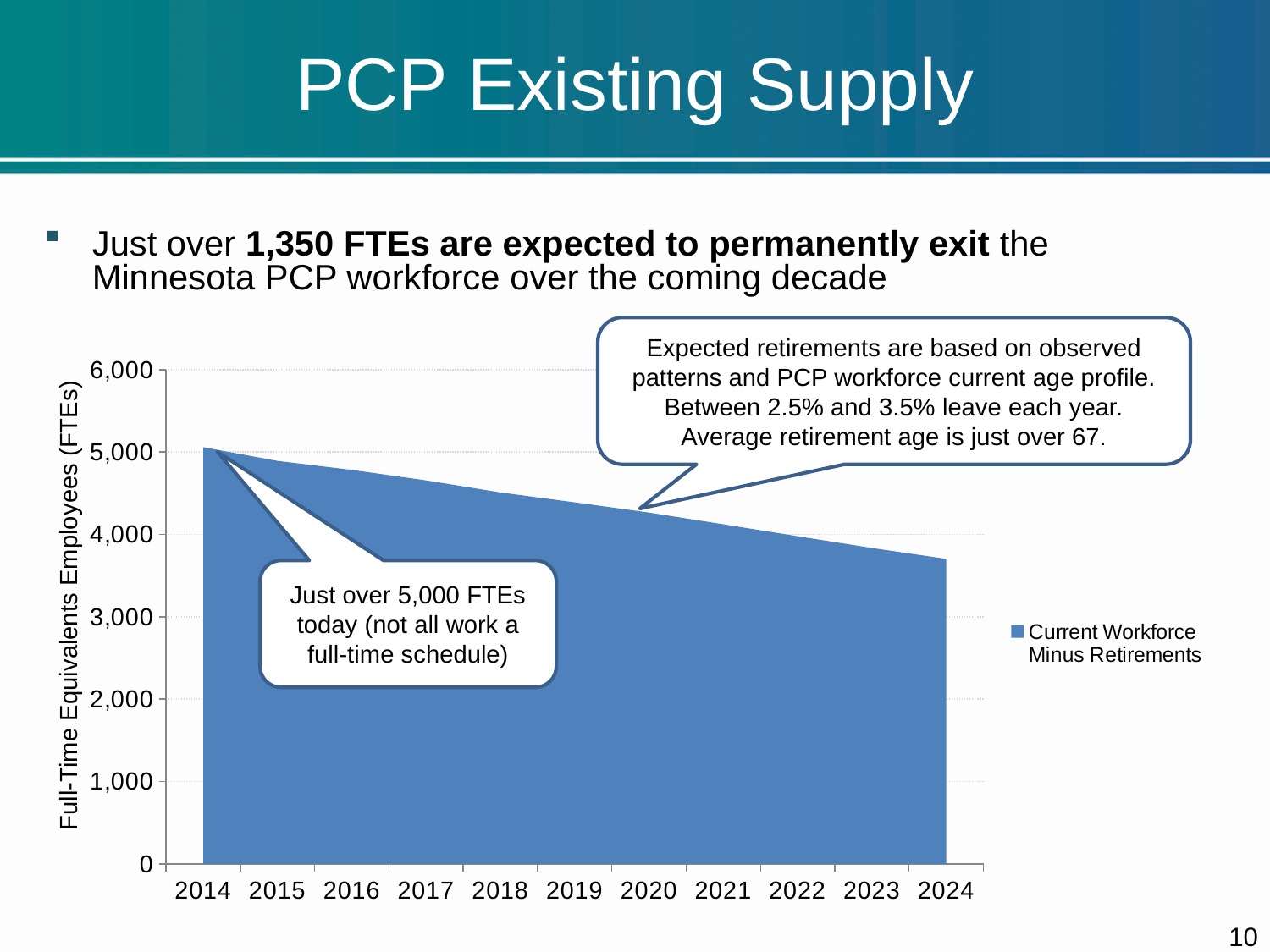
What kind of chart is shown on the slide? area chart Which year has the larger value, 2016 or 2022? 2016 Which year has the lowest value for Current Workforce Minus Retirements? 2024 Do the values rise or fall from 2014 to 2024? fall What is the name of the series shown in the legend? Current Workforce Minus Retirements How many series does the legend list? 1 Is the value for 2024 greater or less than 4,000? less What is the label on the y axis? Full-Time Equivalents Employees (FTEs) How many years are shown along the x axis? 11 Is the value for 2014 greater or less than 4,000? greater Which year has the highest value for Current Workforce Minus Retirements? 2014 Is the value for 2024 greater or less than 3,000? greater